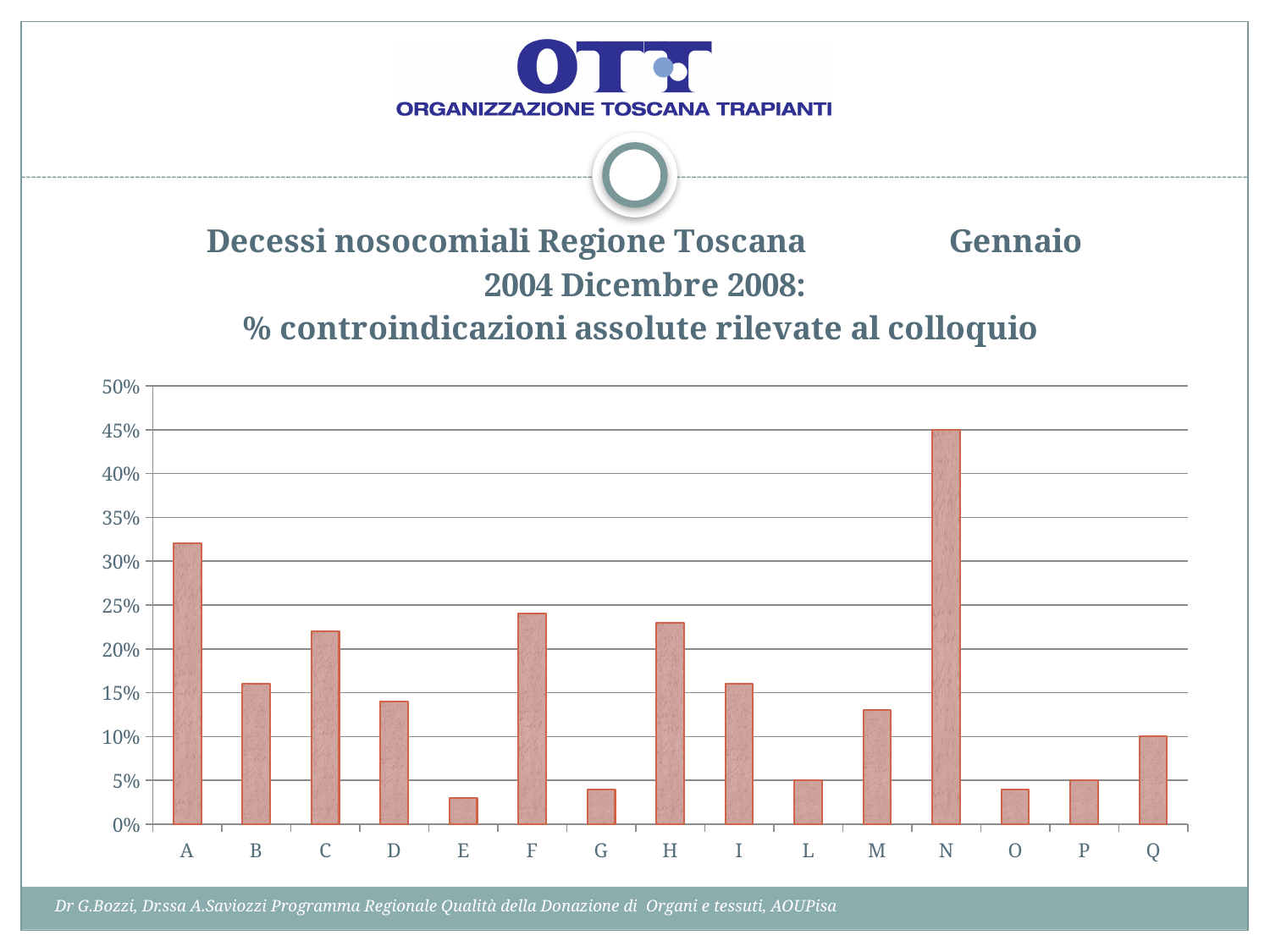
What kind of chart is shown on the slide? bar chart Is the value for D greater or less than 15%? less What is the value for category Q? 10% Which has a larger value, M or B? B Is the value for H greater or less than 20%? greater Is the value for E greater or less than 5%? less What is the value for category N? 45% Which has a larger value, A or C? A Which category has the highest value in the chart? N How many categories are shown on the x axis of the chart? 15